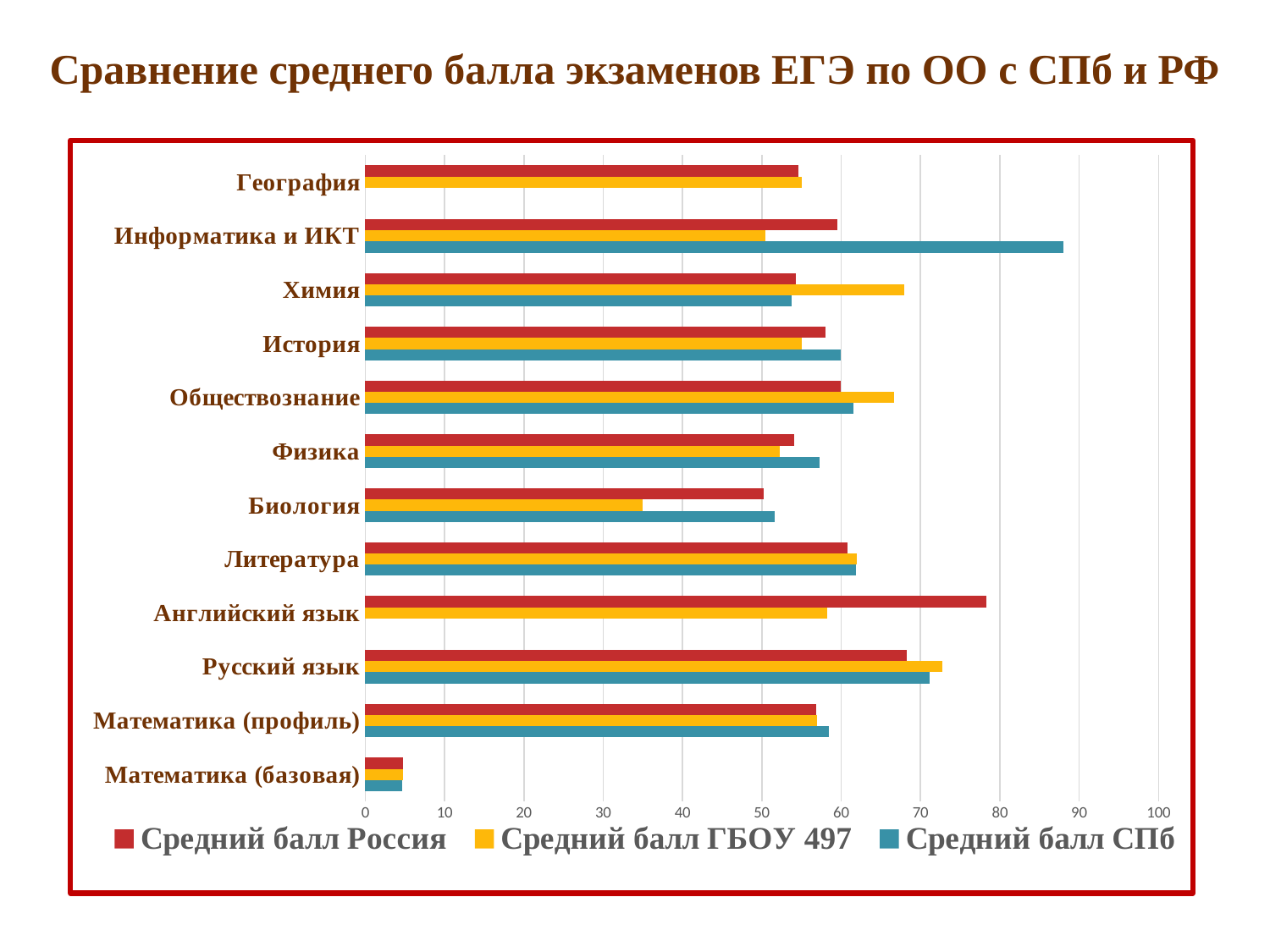
Is the value of Средний балл СПб for Информатика и ИКТ greater or less than 80? greater Which subject has the lowest value for Средний балл Россия? Математика (базовая) Which subject has the highest value for Средний балл СПб? Информатика и ИКТ Which colour represents Средний балл Россия in the legend? red How many series does the legend list? 3 For Химия, which is larger: Средний балл ГБОУ 497 or Средний балл Россия? Средний балл ГБОУ 497 Is the value of Средний балл Россия for Английский язык greater or less than 70? greater What kind of chart is shown on the slide? bar chart Is the value of Средний балл ГБОУ 497 for Биология greater or less than 40? less For Информатика и ИКТ, which is larger: Средний балл СПб or Средний балл Россия? Средний балл СПб How many subjects (categories) are listed on the chart? 12